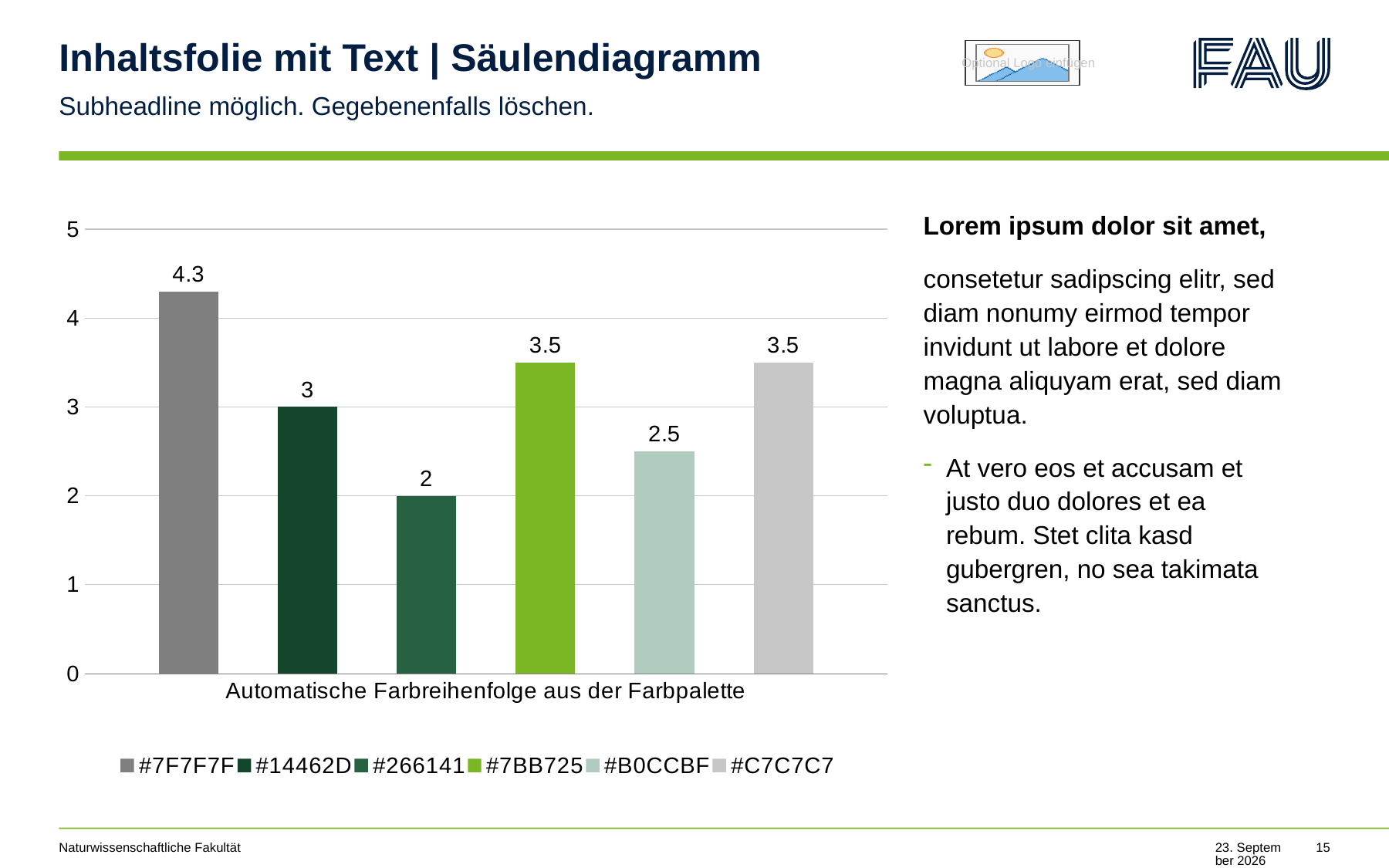
What is the difference between the #7BB725 value and the #266141 value? 1.5 What is the category label shown on the x axis? Automatische Farbreihenfolge aus der Farbpalette What is the value of the #266141 series? 2 What is the value of the #14462D series? 3 How many series does the legend list? 6 Which series has the highest value? #7F7F7F What is the value of the #7F7F7F series? 4.3 Which series has the lowest value? #266141 What is the value of the #B0CCBF series? 2.5 Which is larger, the value for #7BB725 or the value for #B0CCBF? #7BB725 What kind of chart is shown on the slide? Bar chart What is the difference between the #7F7F7F value and the #14462D value? 1.3